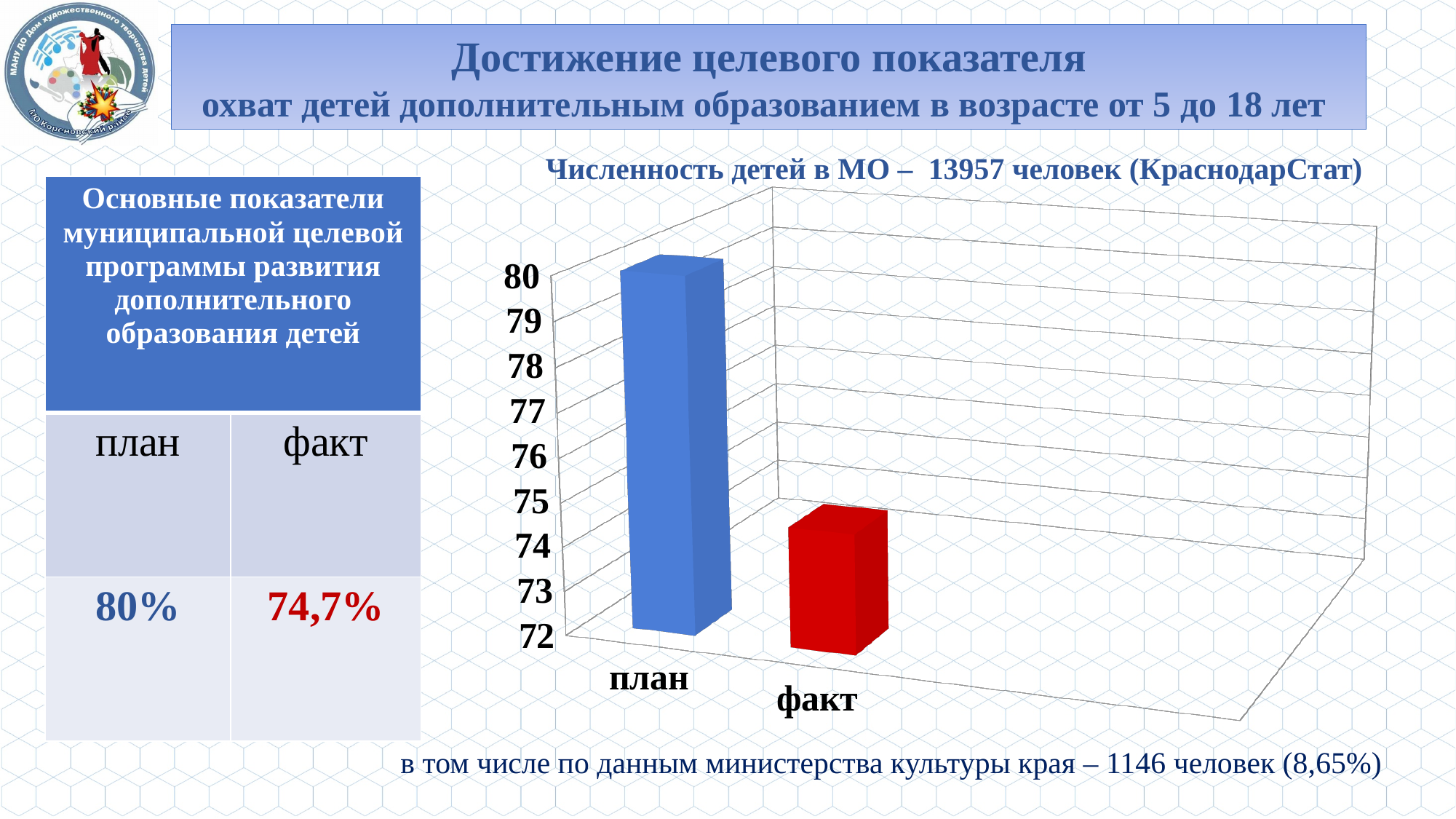
Which category has the lowest bar in the chart? факт What colour is the факт bar? red What is the lowest value shown on the vertical axis of the chart? 72 What kind of chart is shown on the slide? bar chart Which category has the highest bar in the chart? план Is the value for план greater or less than 79? greater How many bars are plotted in the chart? 2 What value does the план bar reach on the vertical axis? 80 Which bar is taller, план or факт? план Is the value for факт greater or less than 75? less Is the value for факт greater or less than 74? greater